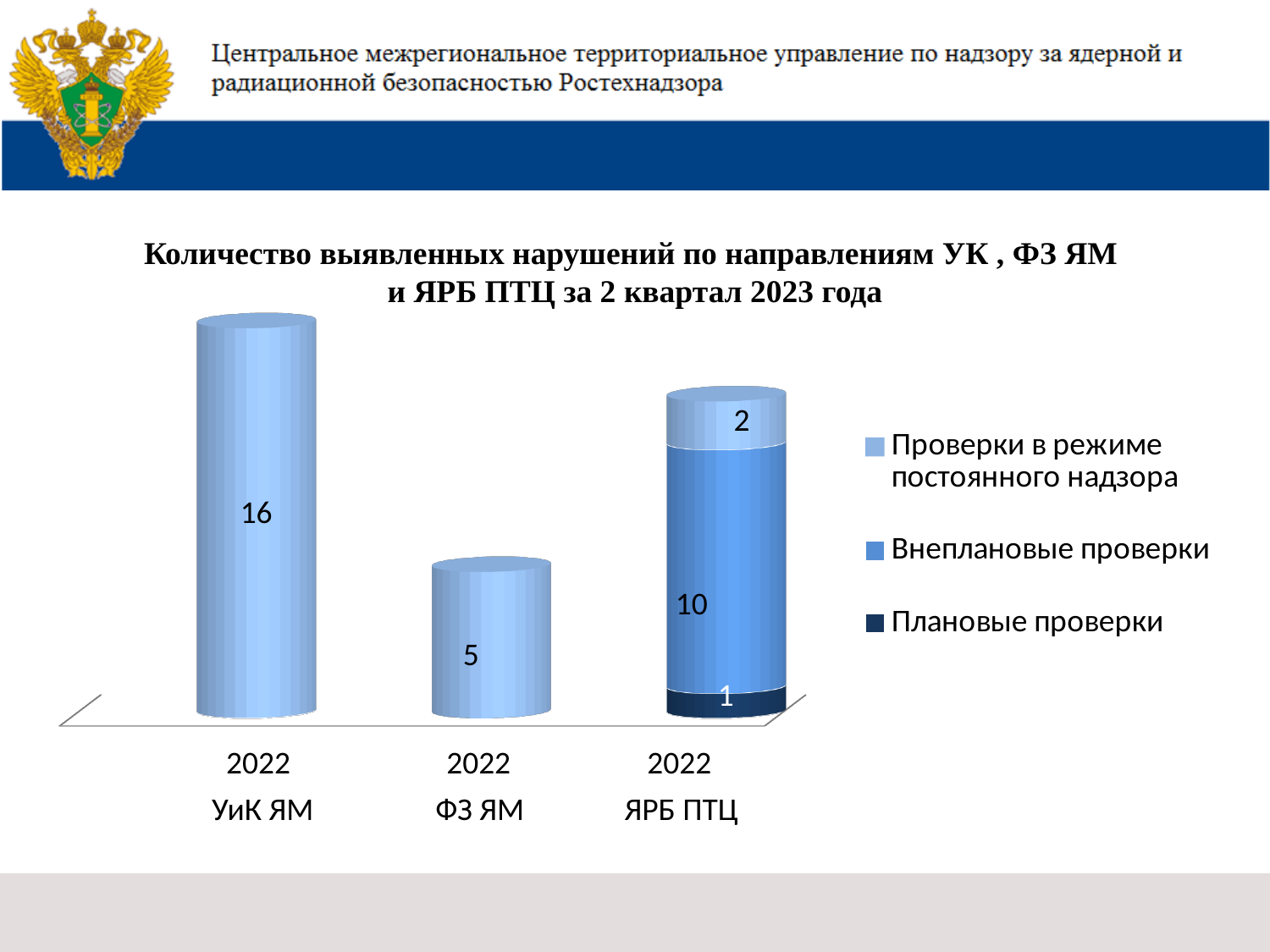
What is the value for "Проверки в режиме постоянного надзора" in the ЯРБ ПТЦ category? 2 What is the value for "Проверки в режиме постоянного надзора" in the ФЗ ЯМ category? 5 What is the difference between the "Проверки в режиме постоянного надзора" values for УиК ЯМ and ФЗ ЯМ? 11 How many series does the legend list? 3 What is the value for "Внеплановые проверки" in the ЯРБ ПТЦ category? 10 Which category has the lowest total bar height? ФЗ ЯМ What is the total of the stacked bar for ЯРБ ПТЦ? 13 What is the value for "Плановые проверки" in the ЯРБ ПТЦ category? 1 What kind of chart is shown on the slide? Stacked bar chart Which category has the highest value for "Проверки в режиме постоянного надзора"? УиК ЯМ What is the value for "Проверки в режиме постоянного надзора" in the УиК ЯМ category? 16 Which is larger: the "Внеплановые проверки" value for ЯРБ ПТЦ or the "Проверки в режиме постоянного надзора" value for ФЗ ЯМ? Внеплановые проверки for ЯРБ ПТЦ